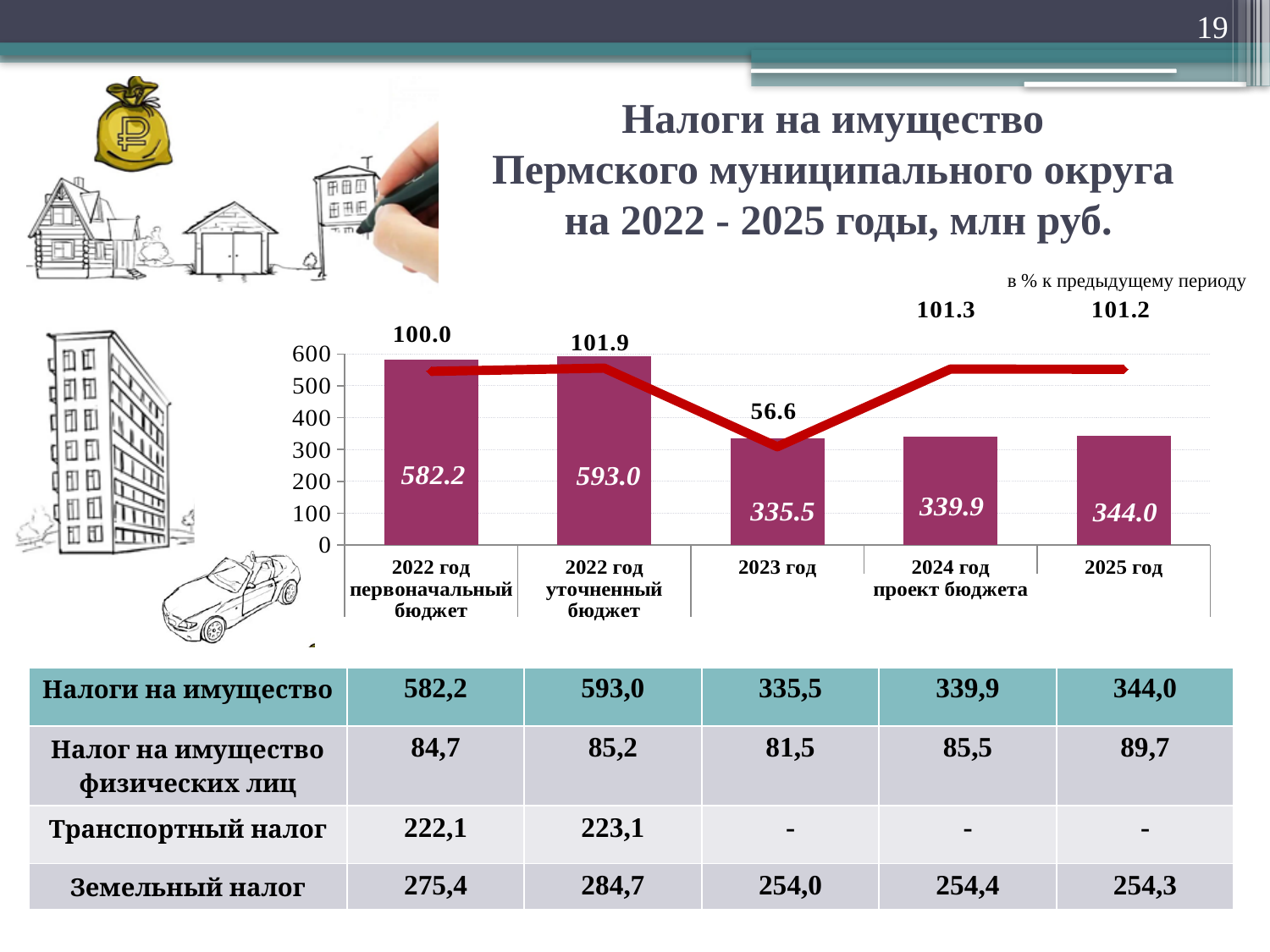
How many bars are plotted in the chart? 5 What is the value of the bar for 2023 год? 335.5 What percentage to the previous period is shown on the line for 2024 год? 101.3 What percentage to the previous period is shown on the line for 2023 год? 56.6 Do the bar values rise or fall from 2023 год to 2025 год? Rise What is the value of the bar for 2025 год? 344.0 What is the value of the bar for 2022 год уточненный бюджет? 593.0 Which is larger, the bar value for 2024 год or for 2025 год? 2025 год Which category has the lowest bar value? 2023 год What is the difference between the bar values for 2022 год уточненный бюджет and 2022 год первоначальный бюджет? 10.8 Which category has the highest bar value? 2022 год уточненный бюджет What kind of chart is shown on the slide? Combined bar and line chart